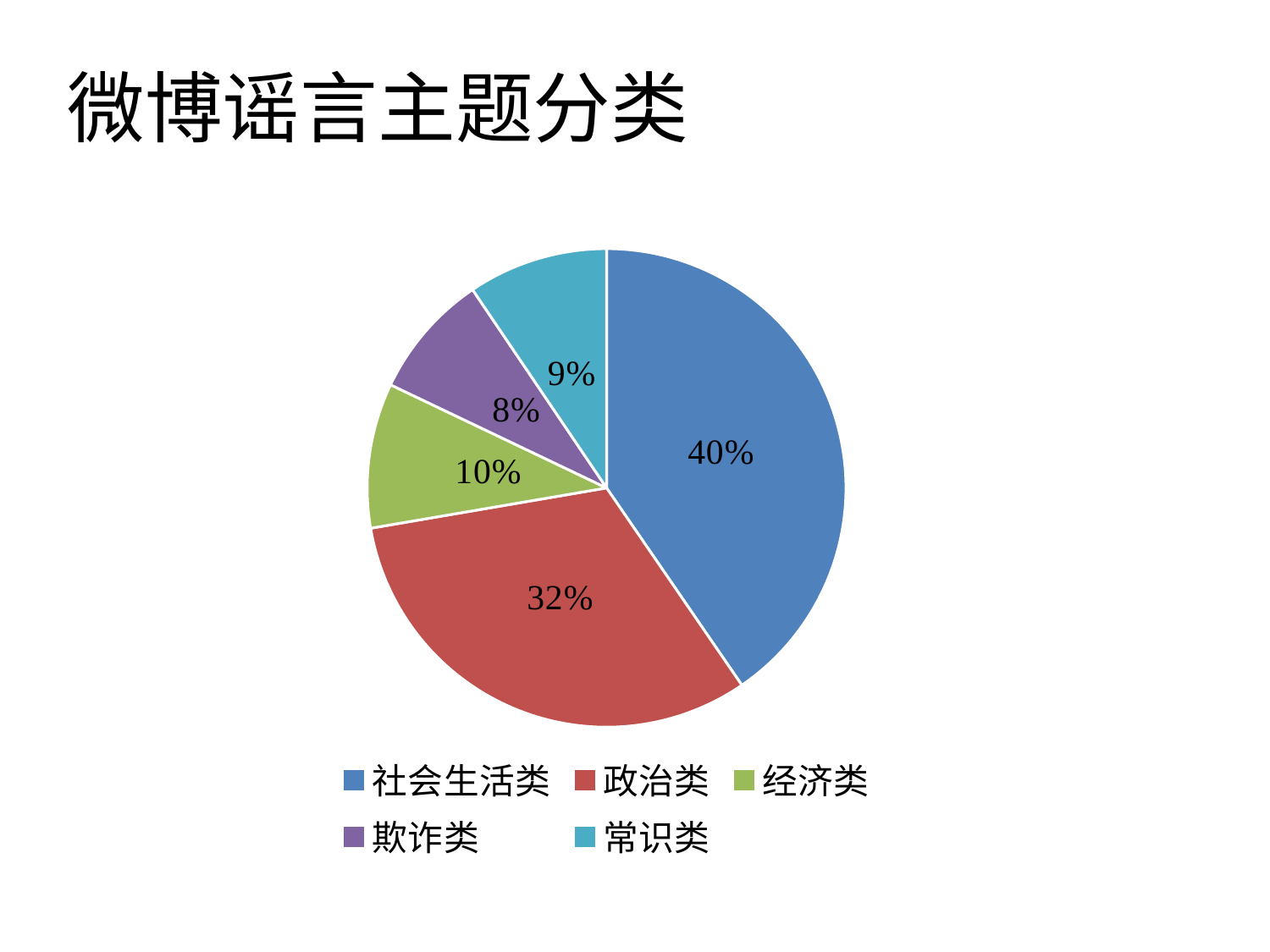
Which category has the smallest share of the pie? 欺诈类 Which category has the largest share of the pie? 社会生活类 What is the value shown for 欺诈类? 8% What share of the pie does 社会生活类 account for? 40% What is the value shown for 常识类? 9% What is the value shown for 政治类? 32% What is the difference between the shares of 社会生活类 and 政治类? 8% What is the value shown for 经济类? 10% What kind of chart is shown on the slide? Pie chart How many categories are shown in the pie chart? 5 Which is larger, the share of 经济类 or the share of 常识类? 经济类 What is the title of the slide? 微博谣言主题分类